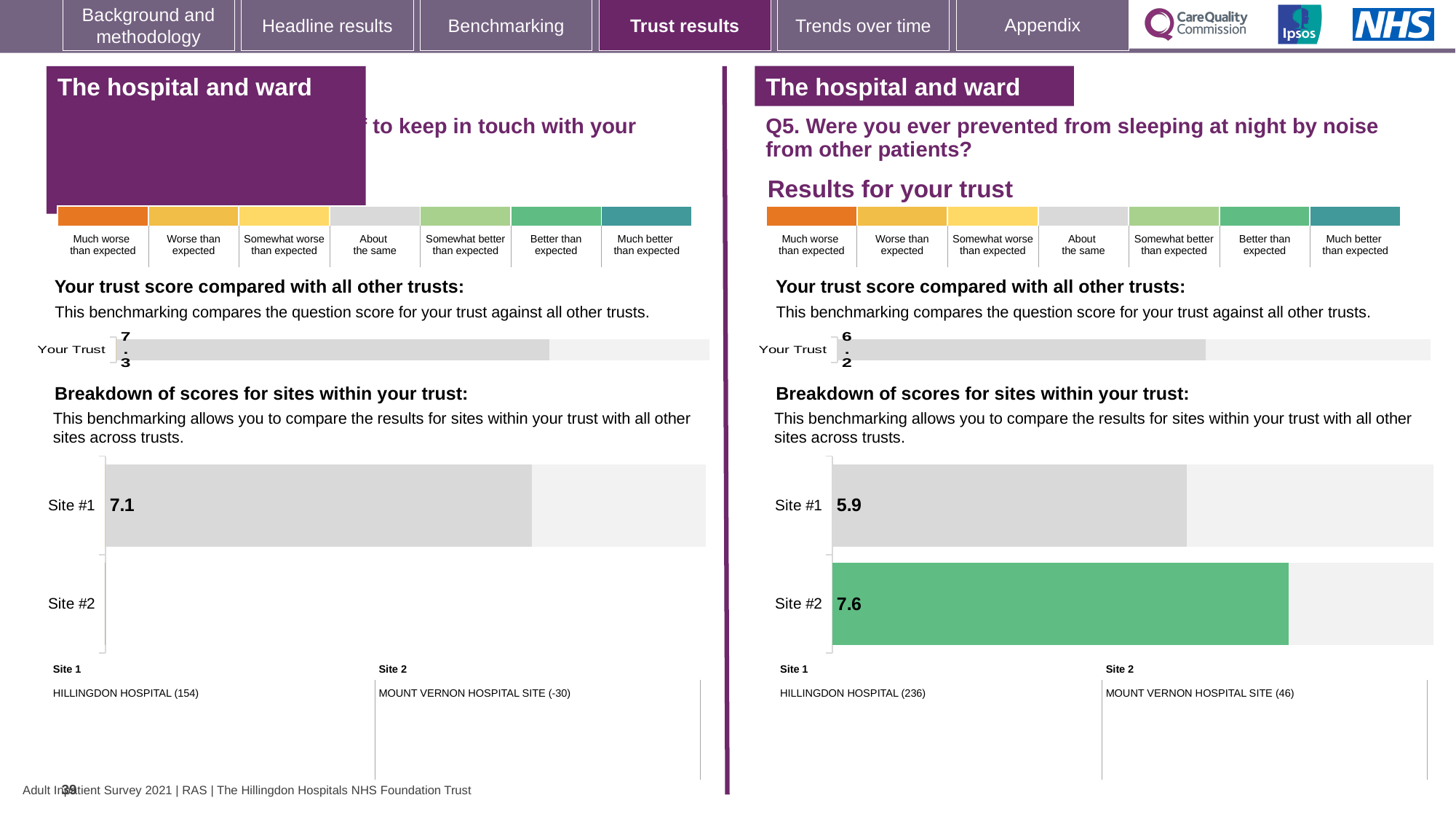
In the right-hand site breakdown chart (Q5), which site has the higher score? Site #2 In the right-hand site breakdown chart (Q5), what is the difference between the Site #2 score and the Site #1 score? 1.7 What type of chart is used for the site breakdown on the right-hand side of the slide (Q5)? bar chart In the right-hand 'Breakdown of scores for sites within your trust' chart (Q5), what is the score for Site #2? 7.6 In the right-hand 'Breakdown of scores for sites within your trust' chart (Q5), what is the score for Site #1? 5.9 In the right-hand site breakdown chart (Q5), what colour is the bar for Site #2? green In the left-hand 'Breakdown of scores for sites within your trust' chart, what is the score for Site #1? 7.1 On the right-hand side of the slide (Q5), what is the score shown for Your Trust in the 'Your trust score compared with all other trusts' chart? 6.2 In the right-hand site breakdown chart (Q5), is the score for Site #1 larger or smaller than the score for Site #2? smaller How many sites are listed in the right-hand site breakdown chart (Q5)? 2 In the right-hand site breakdown chart (Q5), which site has the lower score? Site #1 On the left-hand side of the slide, what is the score shown for Your Trust in the 'Your trust score compared with all other trusts' chart? 7.3